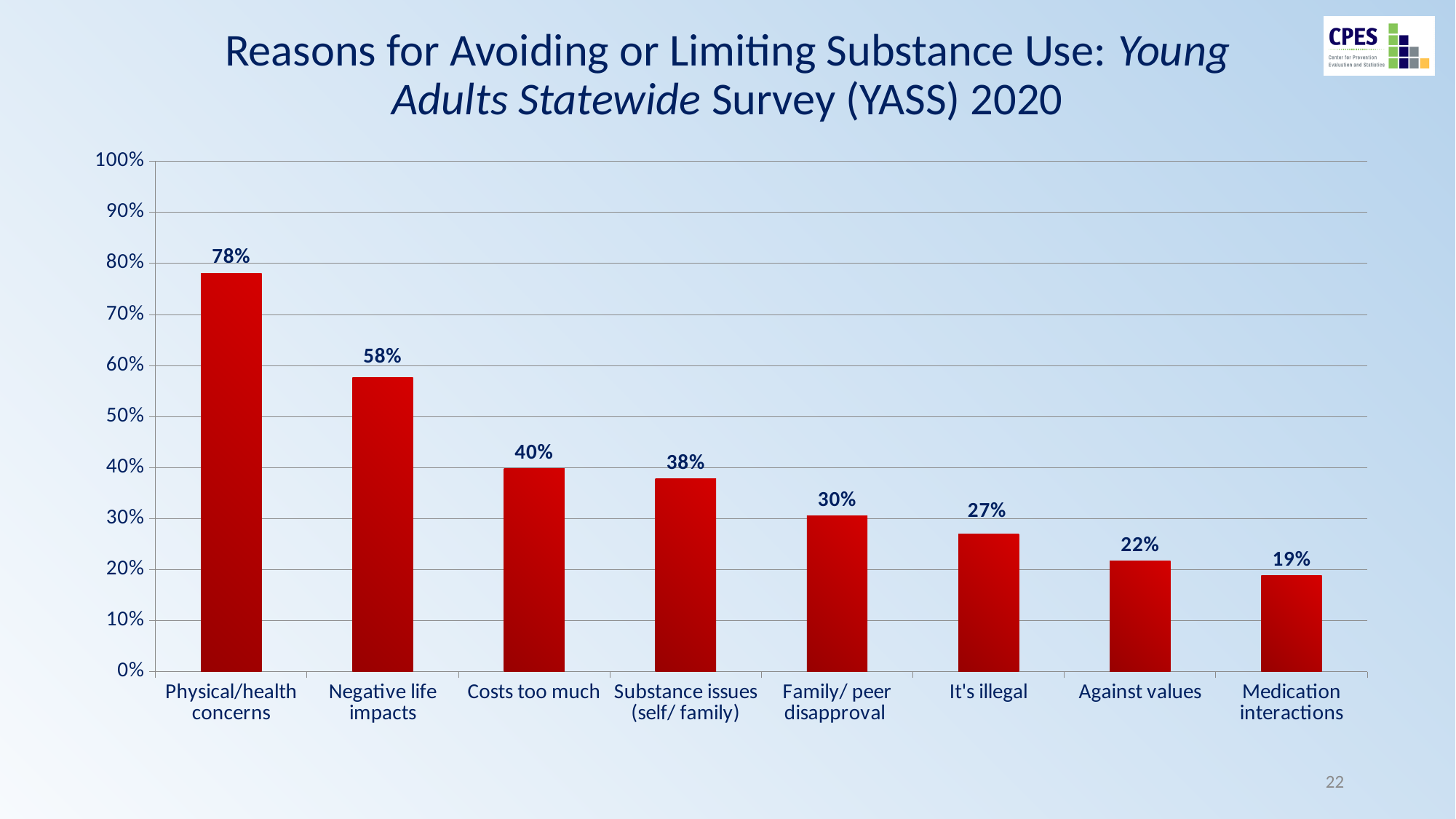
What kind of chart is shown on the slide? Bar chart Which reason has the highest percentage? Physical/health concerns Which reason has the lowest percentage? Medication interactions What is the value for Family/ peer disapproval? 30% What is the difference between the values for Physical/health concerns and Negative life impacts? 20% Which is larger, the value for Substance issues (self/ family) or the value for Family/ peer disapproval? Substance issues (self/ family) What percentage of young adults cited Physical/health concerns as a reason for avoiding or limiting substance use? 78% What percentage is shown for Medication interactions? 19% How many reasons (categories) are shown on the chart? 8 Do the values rise or fall moving from left to right along the x axis? Fall What is the value shown for Costs too much? 40% What is the difference between the values for It's illegal and Against values? 5%